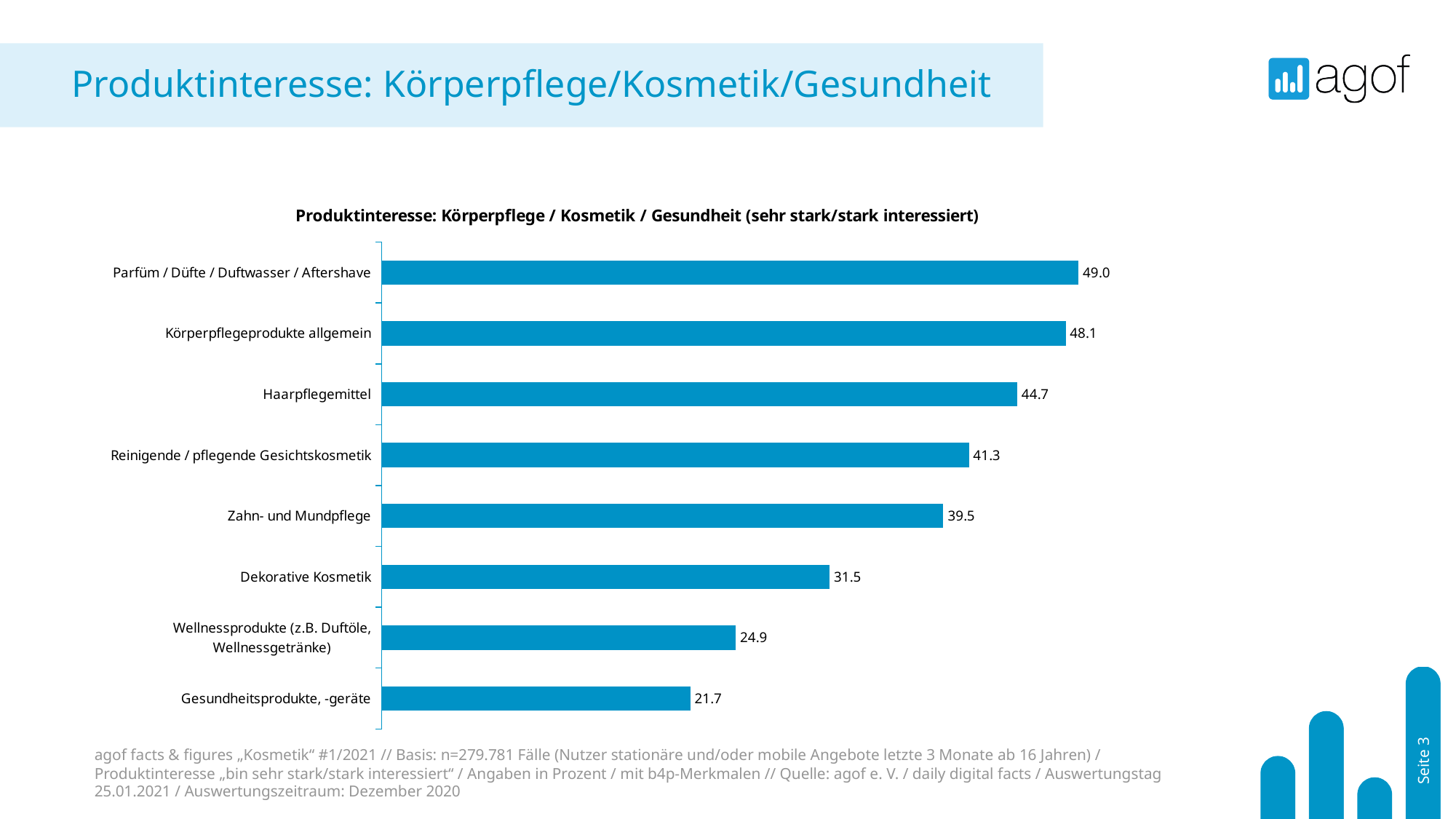
How many categories are shown in the chart? 8 Which category has the highest value? Parfüm / Düfte / Duftwasser / Aftershave What is the difference between the values for Haarpflegemittel and Reinigende / pflegende Gesichtskosmetik? 3.4 What is the difference between the values for Zahn- und Mundpflege and Dekorative Kosmetik? 8.0 What is the value for Gesundheitsprodukte, -geräte? 21.7 Which category has the lowest value? Gesundheitsprodukte, -geräte What is the title of the chart? Produktinteresse: Körperpflege / Kosmetik / Gesundheit (sehr stark/stark interessiert) What is the value for Dekorative Kosmetik? 31.5 What is the value for Körperpflegeprodukte allgemein? 48.1 What is the value for Haarpflegemittel? 44.7 What kind of chart is shown on the slide? Bar chart Which is larger, the value for Wellnessprodukte (z.B. Duftöle, Wellnessgetränke) or the value for Gesundheitsprodukte, -geräte? Wellnessprodukte (z.B. Duftöle, Wellnessgetränke)